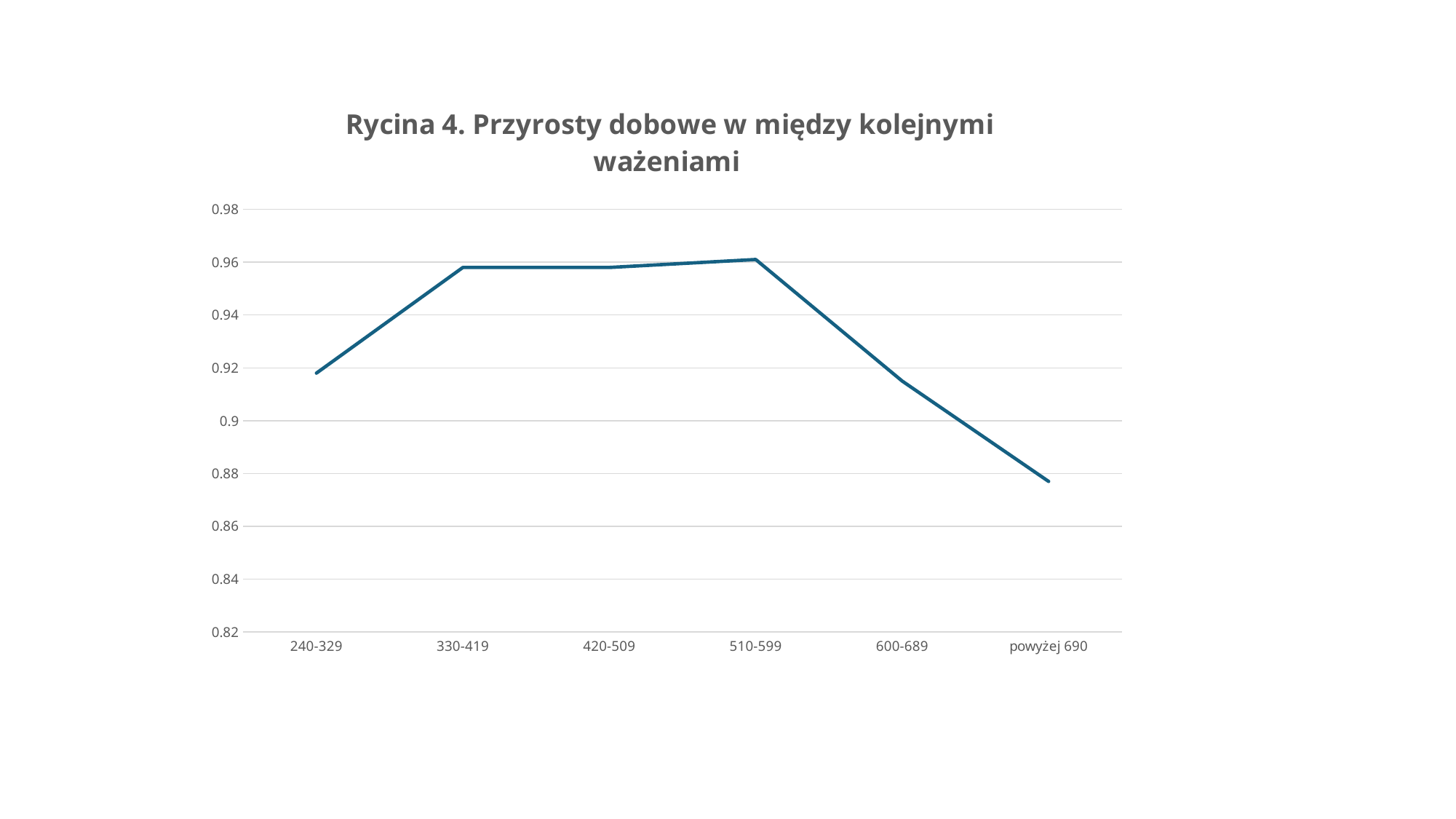
Which is larger, the value for 240-329 or the value for powyżej 690? 240-329 Which is larger, the value for 330-419 or the value for 240-329? 330-419 What is the title of the chart? Rycina 4. Przyrosty dobowe w między kolejnymi ważeniami Do the values rise or fall from 240-329 to 330-419? rise Is the value for 600-689 greater or less than 0.94? less Is the value for 240-329 greater or less than 0.9? greater Is the value for 330-419 greater or less than 0.94? greater Which category has the lowest value? powyżej 690 How many categories are shown on the x axis? 6 Do the values rise or fall from 510-599 to powyżej 690? fall What kind of chart is shown on the slide? Line chart